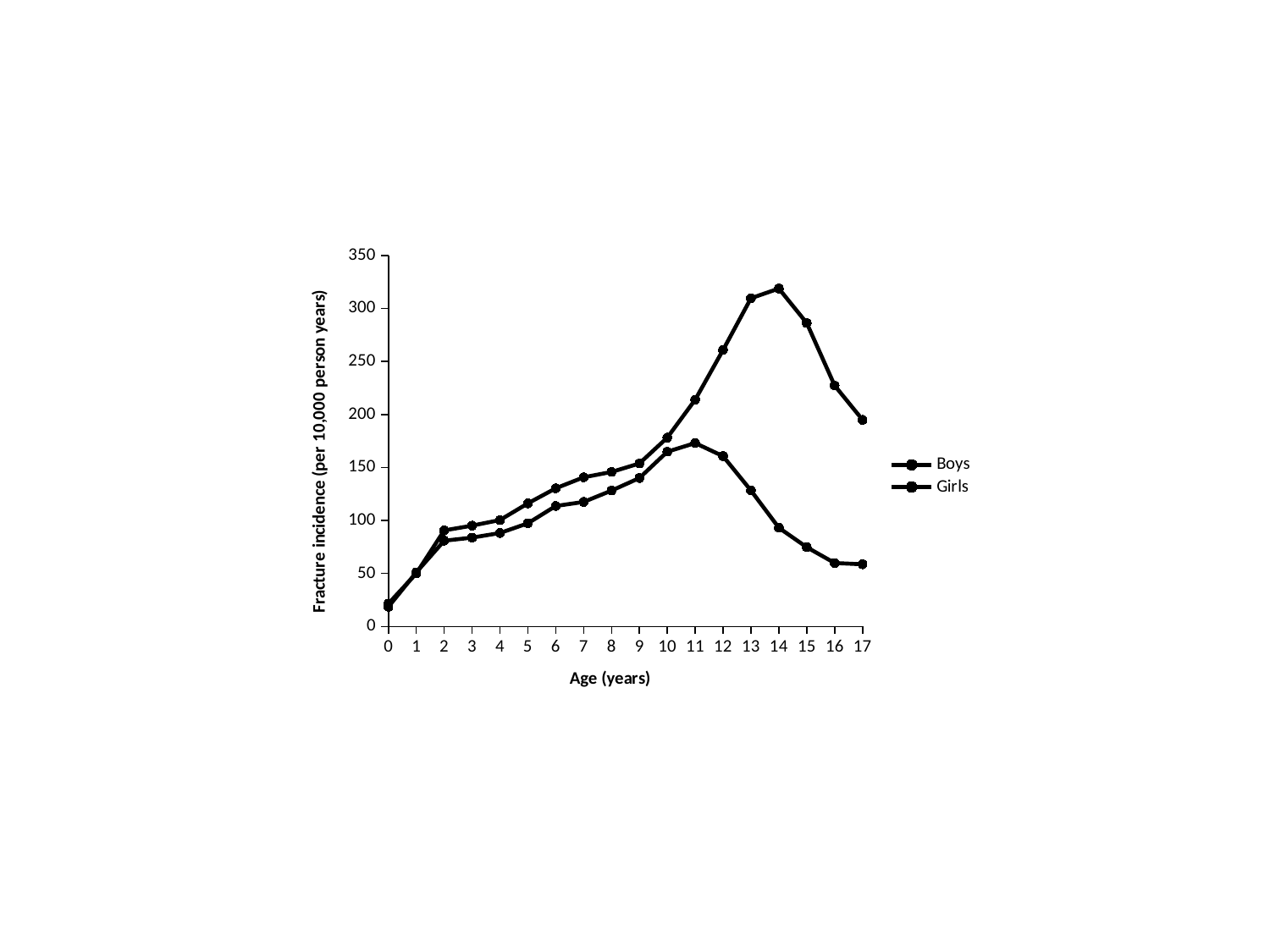
What is the title of the vertical axis? Fracture incidence (per 10,000 person years) What kind of chart is shown on the slide? line chart Between ages 14 and 17, does the higher line rise or fall? fall Is the peak value of the higher line greater or less than 300? greater At what age does the line with the lower peak reach its maximum value? 11 Between ages 0 and 2, do both lines rise or fall? rise How many series does the legend list? 2 What are the two series named in the legend? Boys and Girls At what age does the line with the higher peak reach its maximum value? 14 At age 17, is the value of the lower line greater or less than 100? less How many age points are plotted along the x axis? 18 Is the peak value of the lower line greater or less than 200? less